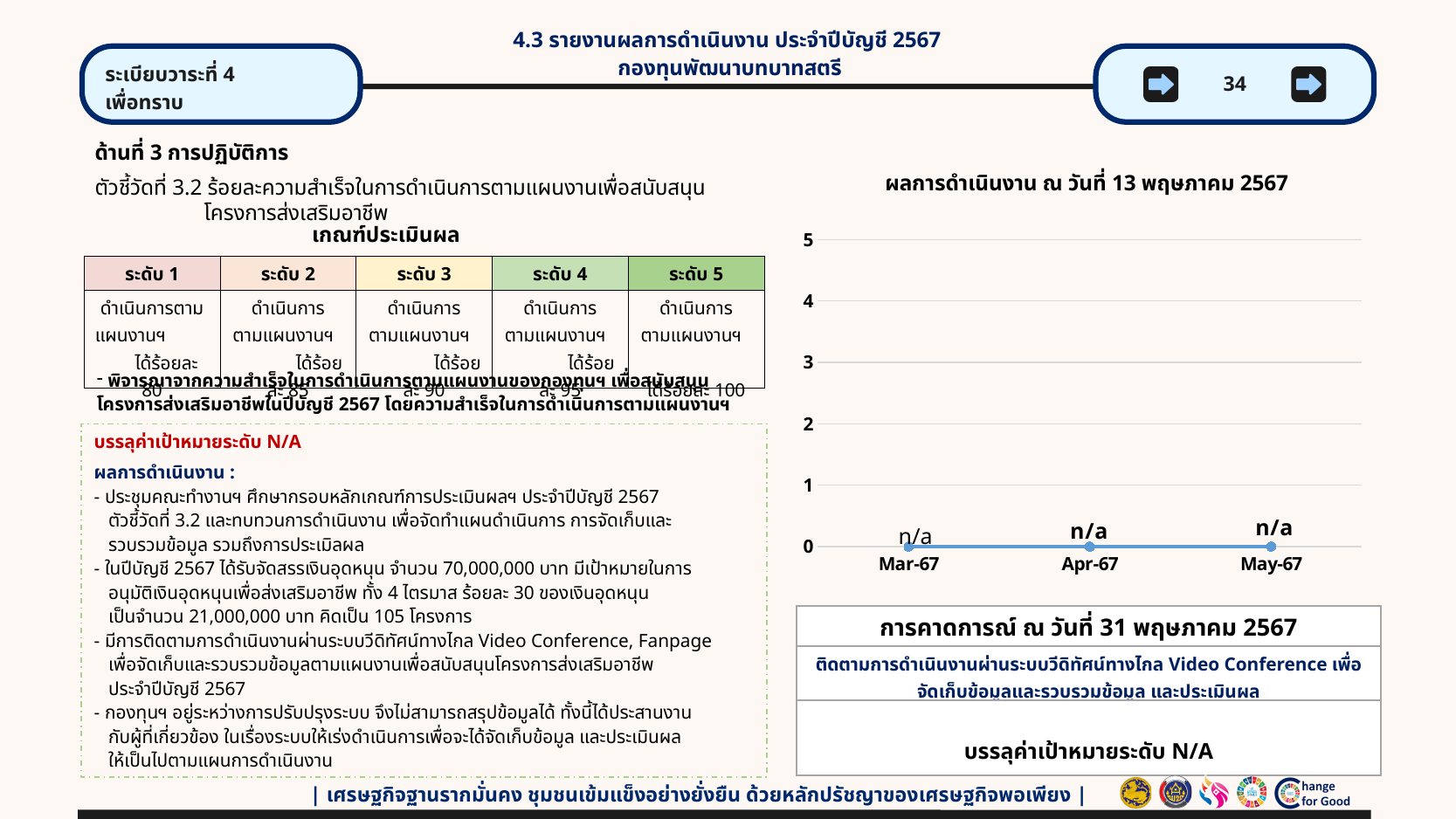
Which category is the first one on the x axis of the chart? Mar-67 How many data points are plotted on the chart? 3 Does the plotted line rise, fall, or stay flat from Mar-67 to May-67? stay flat What is the highest value shown on the chart's vertical axis? 5 Which category is the last one on the x axis of the chart? May-67 What is the data label shown for Apr-67 on the chart? n/a What is the data label shown for May-67 on the chart? n/a What is the data label shown for Mar-67 on the chart? n/a What is the title of the chart? ผลการดำเนินงาน ณ วันที่ 13 พฤษภาคม 2567 What kind of chart is shown on the slide? line chart